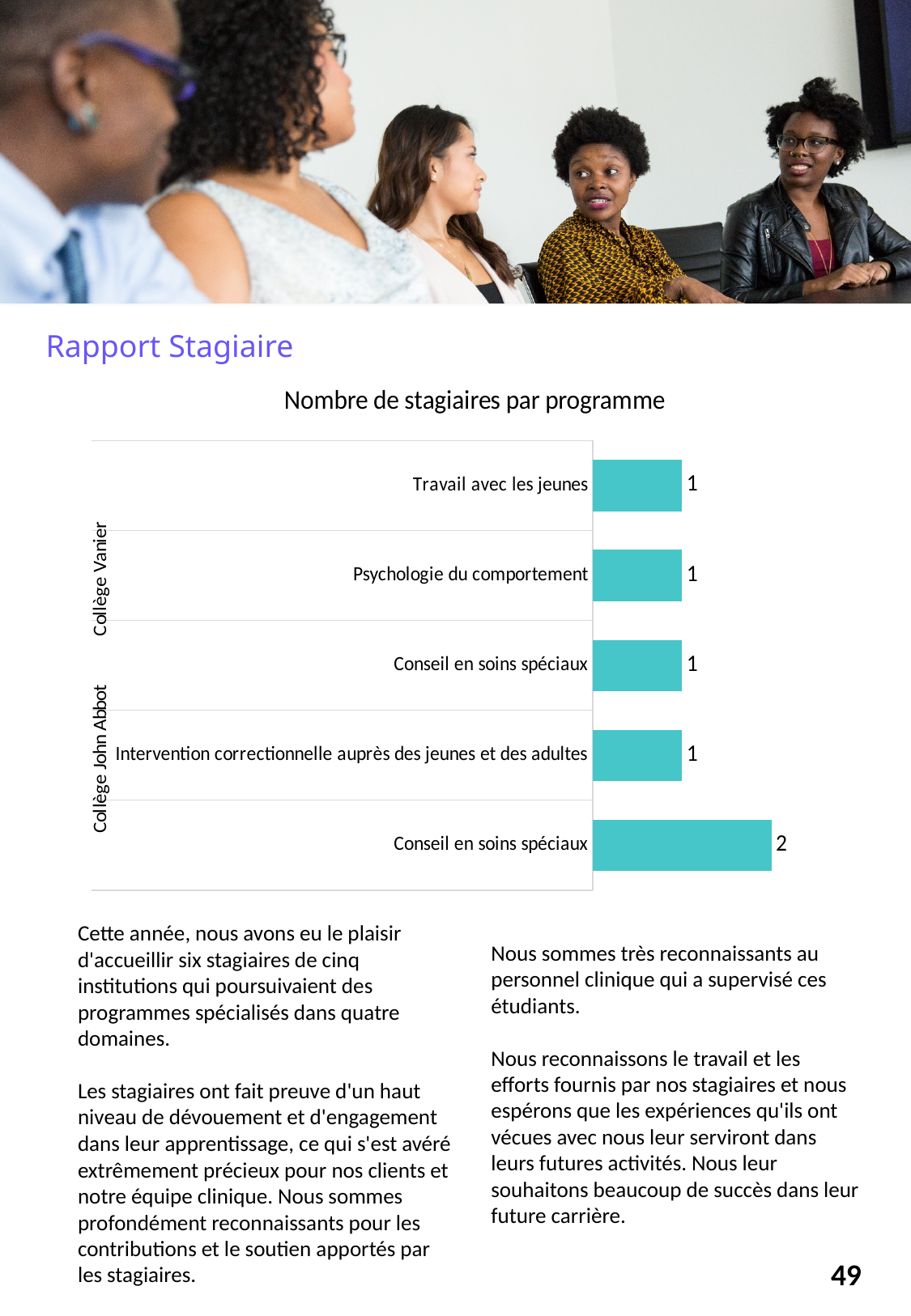
How many bars are plotted in the chart? 5 What is the title of the chart? Nombre de stagiaires par programme Which two colleges are used to group the programs on the vertical axis? Collège Vanier and Collège John Abbot What is the value for Psychologie du comportement? 1 What is the difference between the bottom bar (Conseil en soins spéciaux, 2) and Travail avec les jeunes? 1 What is the value of the bottom bar in the chart? 2 What kind of chart is shown on the slide? Bar chart Which program has the highest number of stagiaires? Conseil en soins spéciaux (bottom bar) How many stagiaires are shown for Travail avec les jeunes? 1 What is the total of all the bar values in the chart? 6 Which is larger: the value for Intervention correctionnelle auprès des jeunes et des adultes or the bottom Conseil en soins spéciaux bar? Conseil en soins spéciaux (bottom bar) What is the value for Intervention correctionnelle auprès des jeunes et des adultes? 1